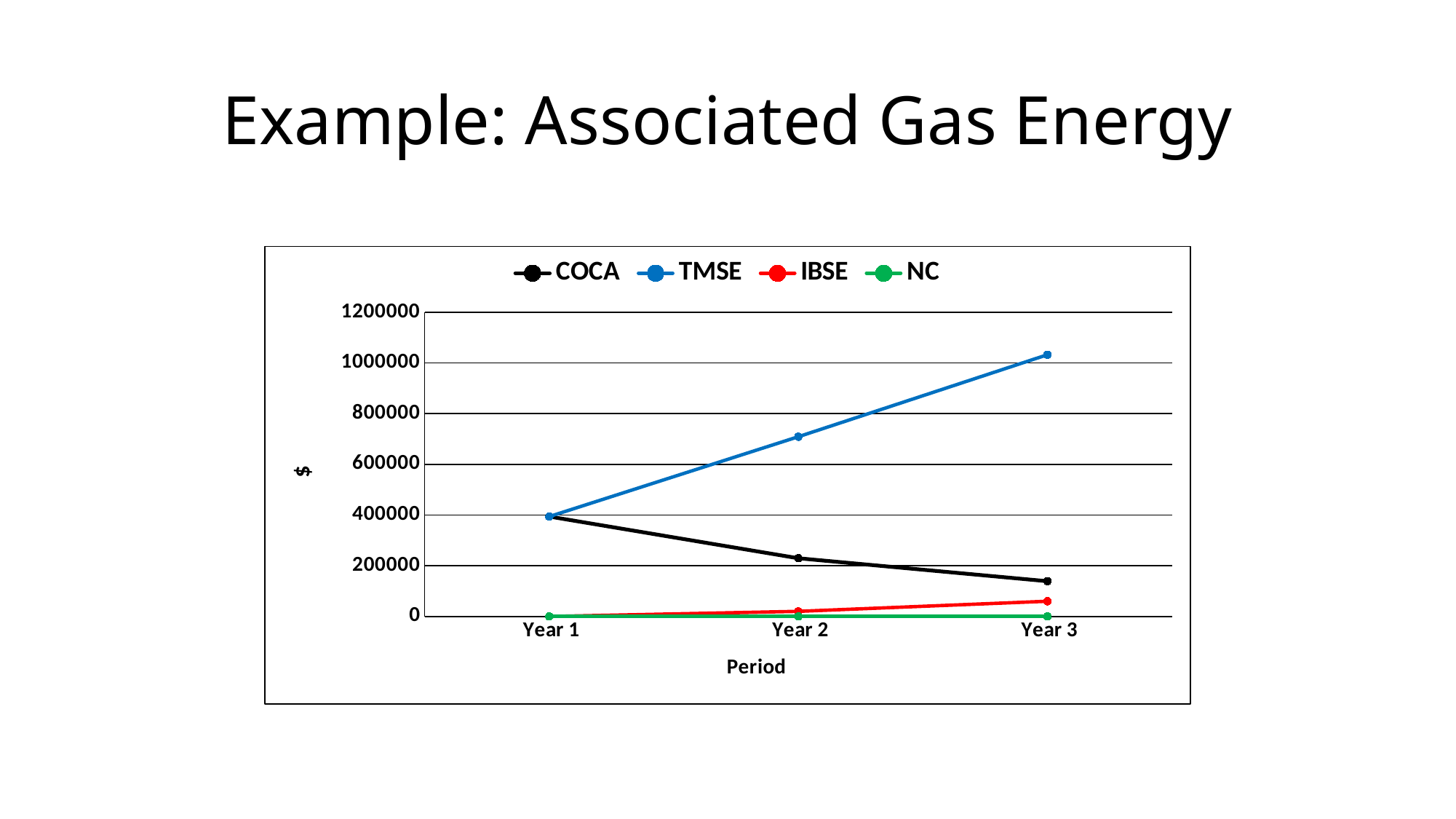
What kind of chart is shown on the slide? line chart Is the value for COCA in Year 3 greater or less than 200000? less In Year 3, which is larger, IBSE or NC? IBSE In Year 2, which is larger, TMSE or COCA? TMSE Is the value for TMSE in Year 3 greater or less than 800000? greater Does the COCA line rise or fall from Year 1 to Year 3? fall Does the TMSE line rise or fall from Year 1 to Year 3? rise Which series has the lowest value in Year 3? NC How many periods are plotted along the x axis? 3 How many series does the legend list? 4 Which series has the highest value in Year 3? TMSE What is the title of the x axis? Period